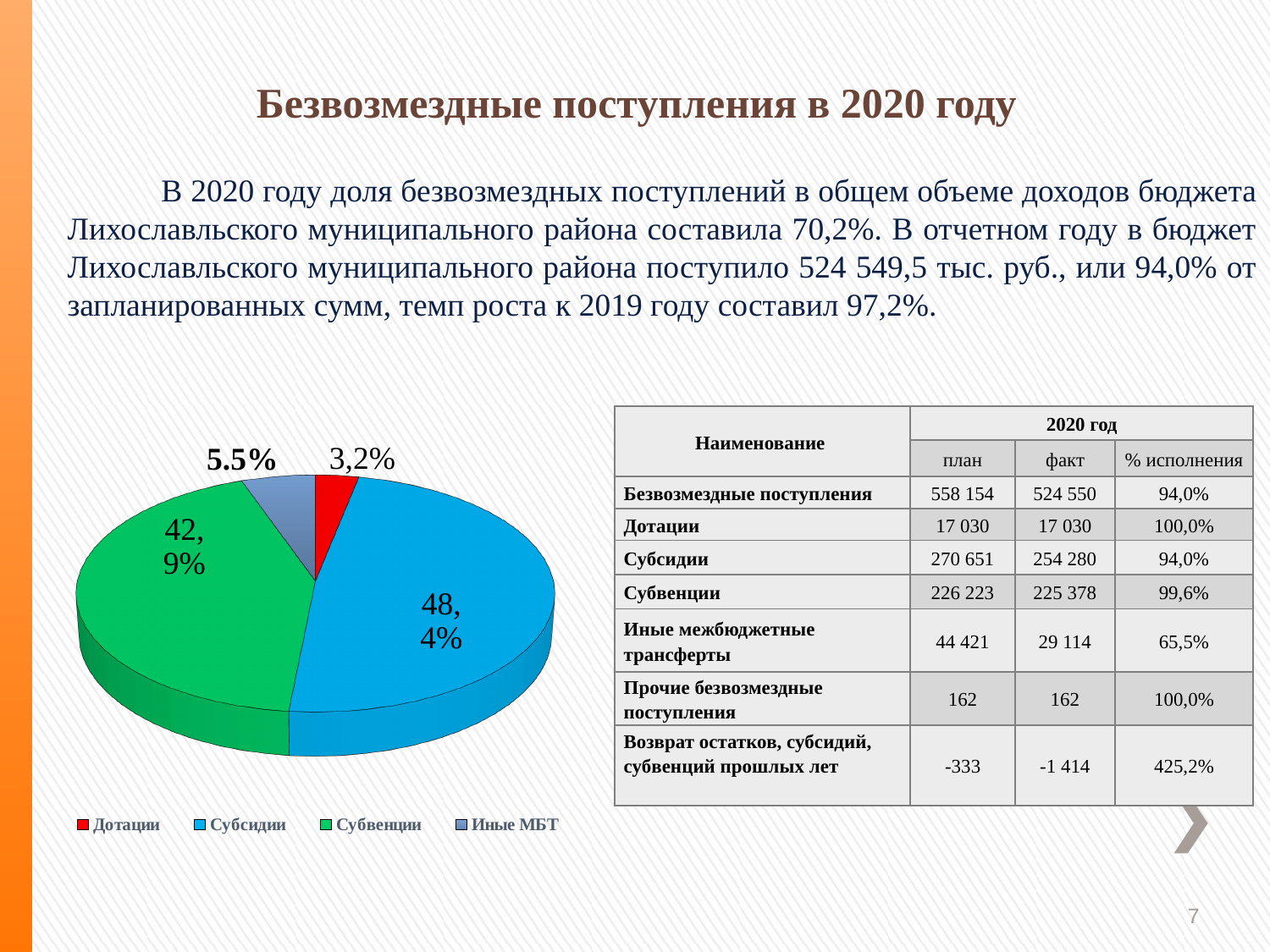
What share of the pie chart does Субвенции represent? 42,9% How many entries does the pie chart legend list? 4 Which category has the smallest slice in the pie chart? Дотации Which category has the largest slice in the pie chart? Субсидии What type of chart is shown on the slide? Pie chart What share of the pie chart does Дотации represent? 3,2% What share of the pie chart does Иные МБТ represent? 5.5% How many slices does the pie chart have? 4 What colour is the Субсидии slice in the pie chart? Blue What is the difference in percentage points between the Субсидии slice and the Субвенции slice? 5,5 Which slice is larger in the pie chart, Субвенции or Иные МБТ? Субвенции What share of the pie chart does Субсидии represent? 48,4%